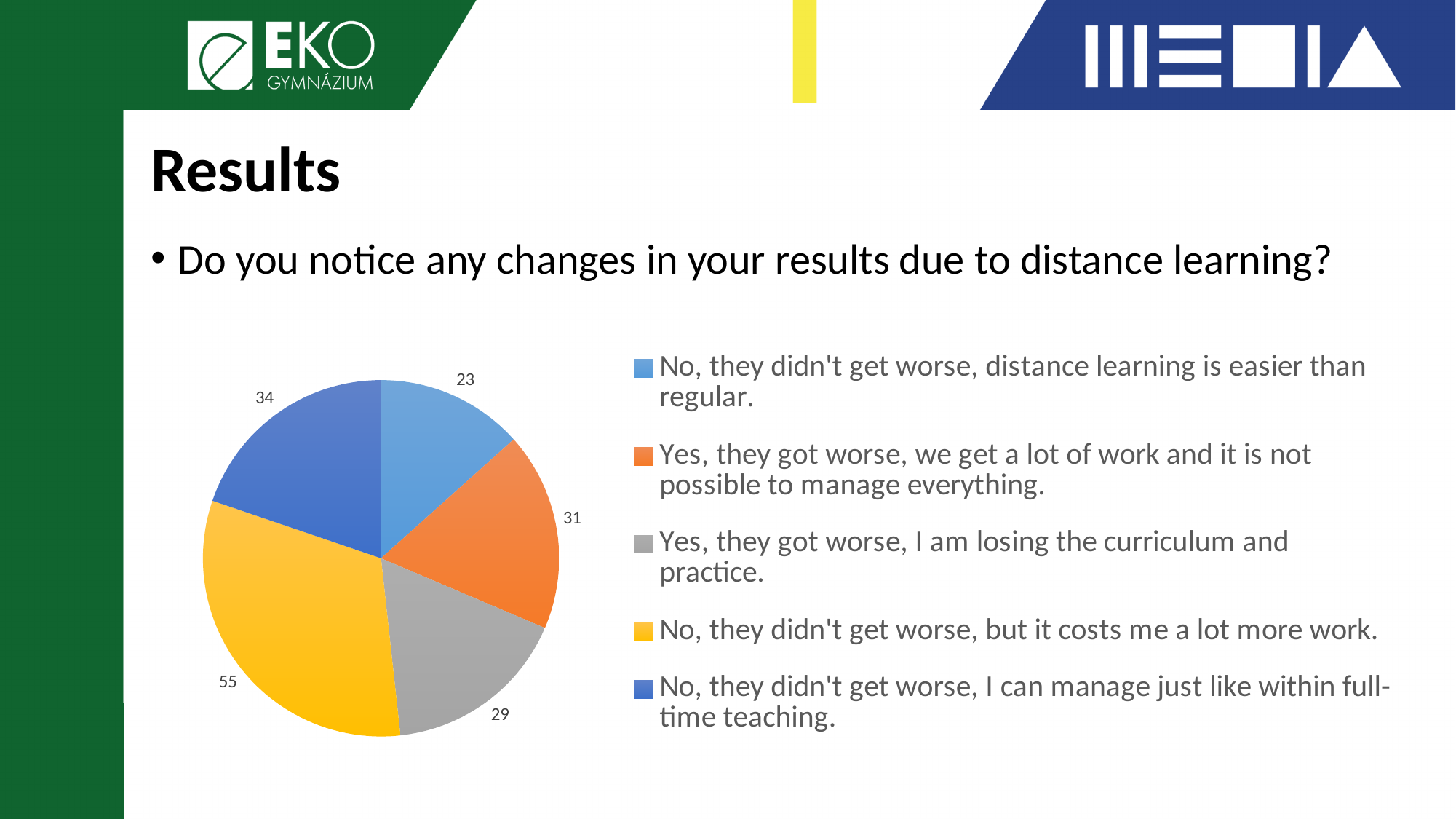
What colour is the slice for "Yes, they got worse, we get a lot of work and it is not possible to manage everything."? orange What is the value for "No, they didn't get worse, distance learning is easier than regular."? 23 What is the total of all the values in the pie chart? 172 Which is larger: the value for "Yes, they got worse, we get a lot of work and it is not possible to manage everything." or the value for "Yes, they got worse, I am losing the curriculum and practice."? Yes, they got worse, we get a lot of work and it is not possible to manage everything. What is the value for "Yes, they got worse, I am losing the curriculum and practice."? 29 Which response has the largest slice of the pie? No, they didn't get worse, but it costs me a lot more work. What is the value for "No, they didn't get worse, I can manage just like within full-time teaching."? 34 What is the difference between the value for "No, they didn't get worse, but it costs me a lot more work." and the value for "No, they didn't get worse, I can manage just like within full-time teaching."? 21 What is the value for "No, they didn't get worse, but it costs me a lot more work."? 55 How many slices does the pie chart have? 5 Which response has the smallest slice of the pie? No, they didn't get worse, distance learning is easier than regular. What type of chart is shown on the slide? pie chart